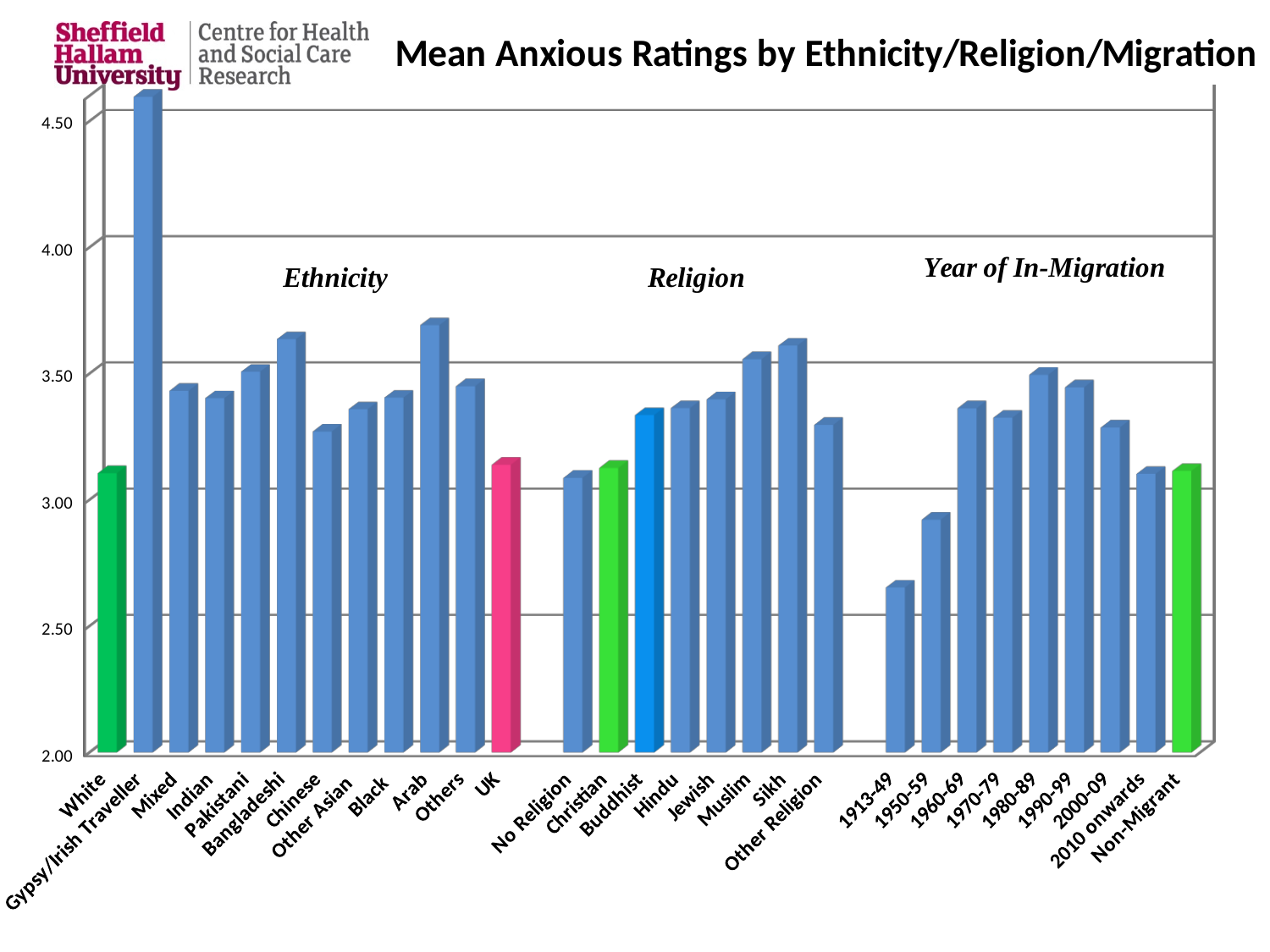
What is the title of the chart? Mean Anxious Ratings by Ethnicity/Religion/Migration Is the value for Gypsy/Irish Traveller greater or less than 4.50? greater How many categories are plotted on the x axis? 29 What kind of chart is shown on the slide? bar chart Is the value for 1950-59 greater or less than 3.00? less Is the value for Arab greater or less than 3.50? greater Which has the higher mean anxious rating, Arab or Chinese? Arab Which category has the lowest mean anxious rating? 1913-49 Which category has the highest mean anxious rating? Gypsy/Irish Traveller Which has the higher mean anxious rating, Sikh or Other Religion? Sikh